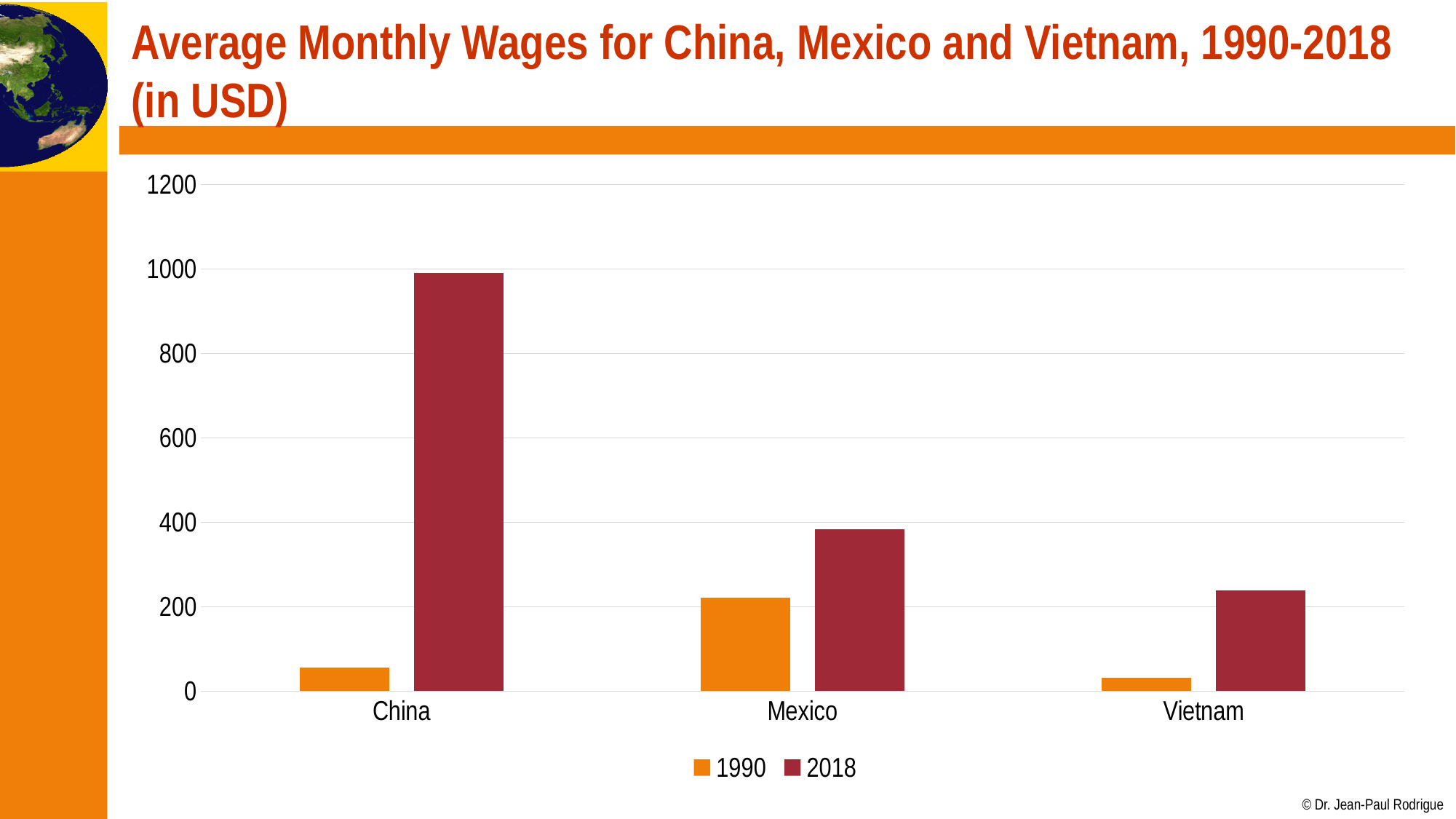
Which country has the highest average monthly wage in 2018? China Which country has the lowest average monthly wage in 2018? Vietnam Is the 1990 value for Vietnam greater or less than 200? less Is the 2018 value for Mexico greater or less than 200? greater What kind of chart is shown on the slide? bar chart Which country has the highest average monthly wage in 1990? Mexico How many countries are shown on the x axis of the chart? 3 Which is larger: the 2018 value for Mexico or the 2018 value for Vietnam? Mexico How many series does the legend list? 2 Is the 1990 value for China greater or less than 200? less Which colour represents the 2018 series in the chart? dark red